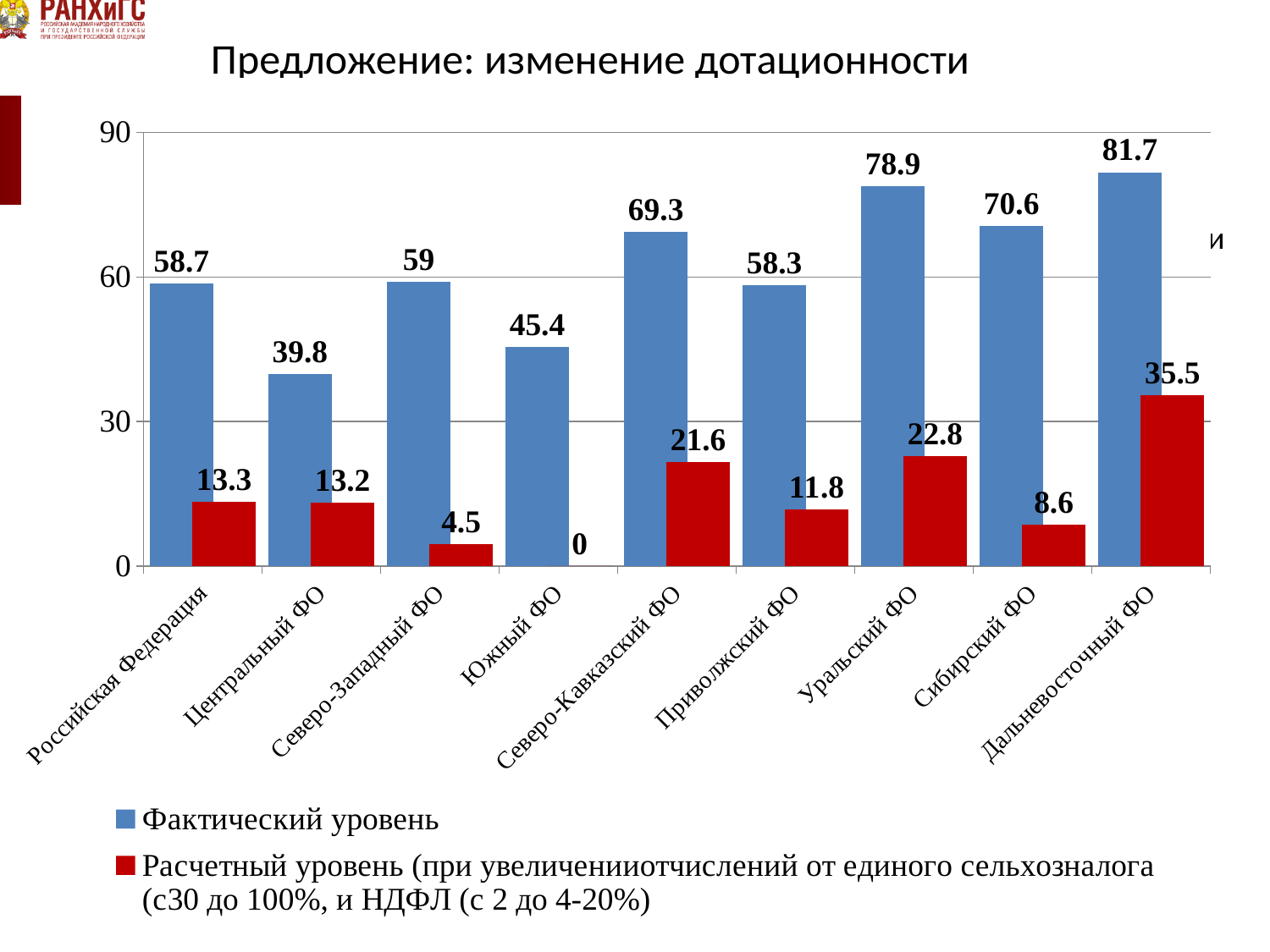
What is the value of «Расчетный уровень» for Северо-Кавказский ФО? 21.6 What is the value of «Фактический уровень» for Уральский ФО? 78.9 What is the value of «Фактический уровень» for Российская Федерация? 58.7 What colour are the bars for «Фактический уровень»? blue Which category has the highest value of «Фактический уровень»? Дальневосточный ФО Is the value of «Фактический уровень» for Центральный ФО greater or less than 30? greater Which is larger: «Расчетный уровень» for Уральский ФО or for Приволжский ФО? Уральский ФО What kind of chart is shown on the slide? bar chart What is the difference between «Фактический уровень» and «Расчетный уровень» for Дальневосточный ФО? 46.2 How many series does the legend list? 2 How many categories are shown on the x axis? 9 Which category has the lowest value of «Расчетный уровень»? Южный ФО